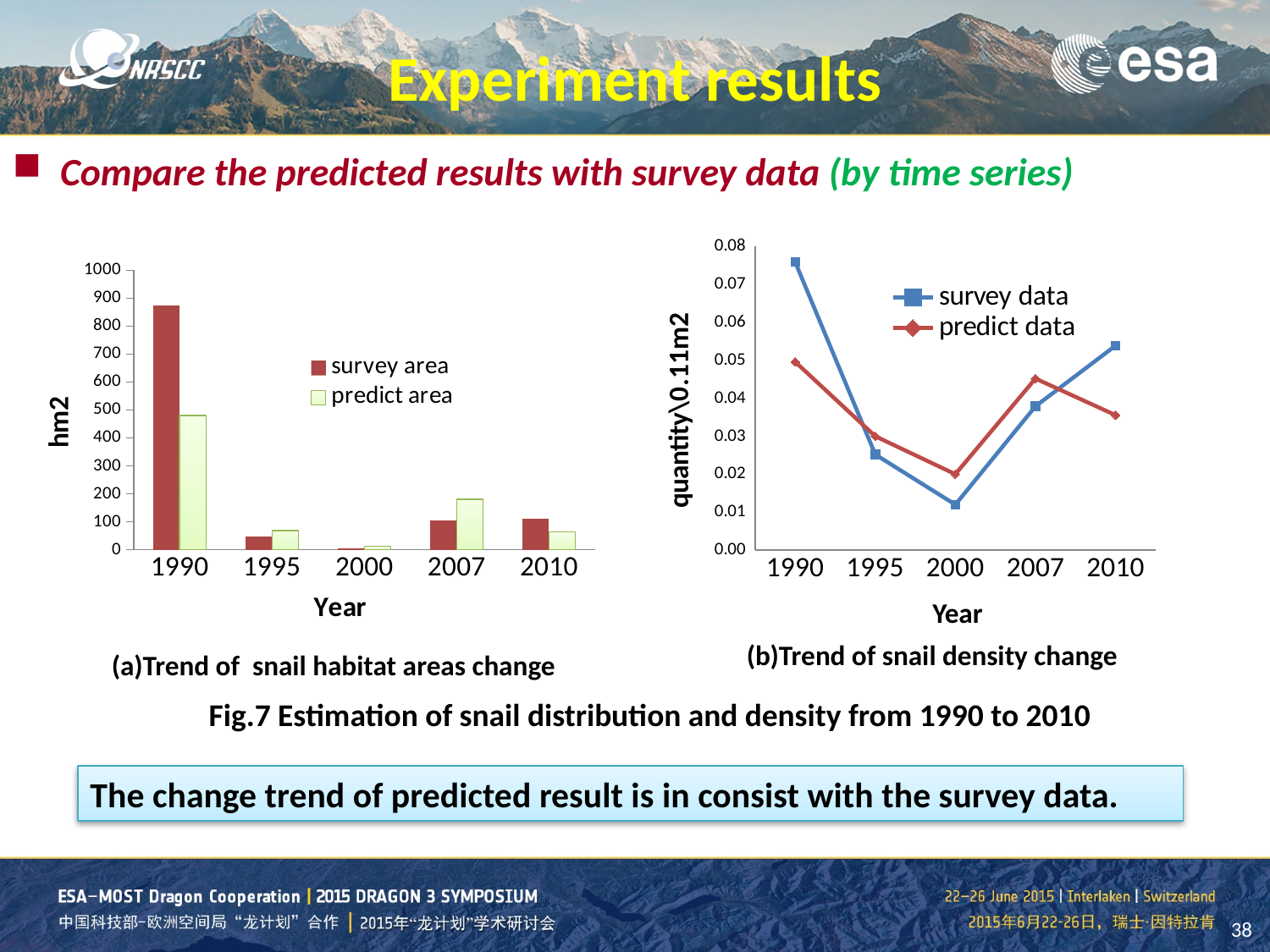
In chart (a) Trend of snail habitat areas change, what kind of chart is used? bar chart In chart (b) Trend of snail density change, which year has the lowest survey data value? 2000 In chart (a) Trend of snail habitat areas change, is the survey area for 1990 greater or less than 800? greater In chart (a) Trend of snail habitat areas change, which year has the lowest survey area? 2000 In chart (a) Trend of snail habitat areas change, how many series does the legend list? 2 In chart (b) Trend of snail density change, does the survey data rise or fall from 1990 to 2000? fall In chart (a) Trend of snail habitat areas change, how many years are shown on the x axis? 5 In chart (b) Trend of snail density change, what kind of chart is used? line chart In chart (a) Trend of snail habitat areas change, which is larger in 2007, the survey area or the predict area? predict area In chart (b) Trend of snail density change, which is larger in 2010, survey data or predict data? survey data In chart (b) Trend of snail density change, is the survey data value for 1990 greater or less than 0.07? greater In chart (a) Trend of snail habitat areas change, which year has the highest survey area? 1990